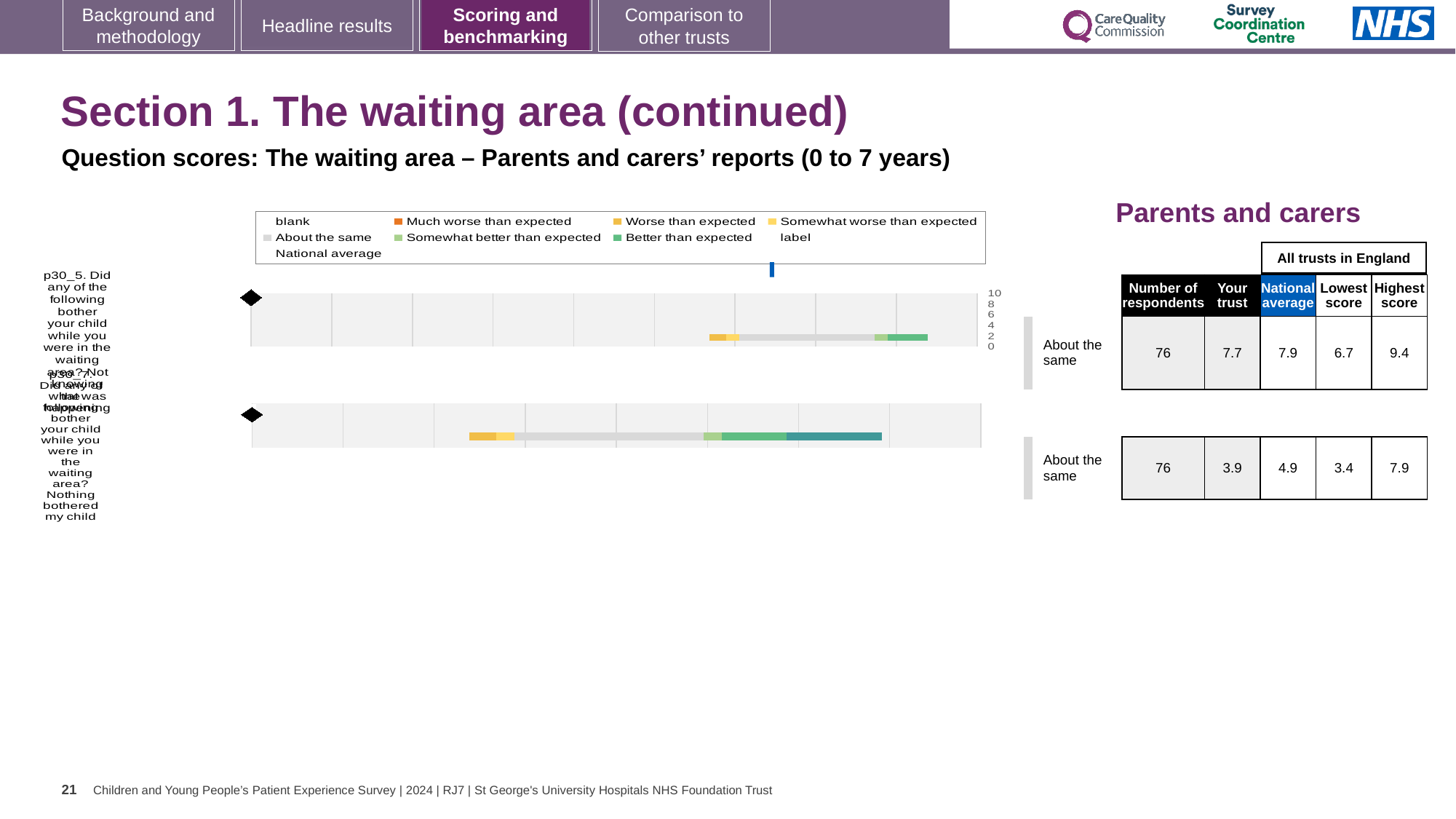
According to the table beside the chart, what is the 'Your trust' score for the first question (p30_5, Not knowing what was happening)? 7.7 What kind of chart is shown on the slide? bar chart What colour does the legend use for 'Much worse than expected'? orange How many survey questions (bars) are plotted in the chart? 2 What benchmark category is shown for both questions in the chart? About the same What is the lowest score across all trusts in England for the first question (p30_5)? 6.7 What is the difference between the national average and the 'Your trust' score for the second question (p30_7)? 1.0 How many respondents answered the first question (p30_5)? 76 What is the difference between the national average and the 'Your trust' score for the first question (p30_5)? 0.2 What is the highest score across all trusts in England for the second question (p30_7)? 7.9 According to the table beside the chart, what is the national average for the second question (p30_7, Nothing bothered my child)? 4.9 Which question has the higher 'Your trust' score, p30_5 or p30_7? p30_5